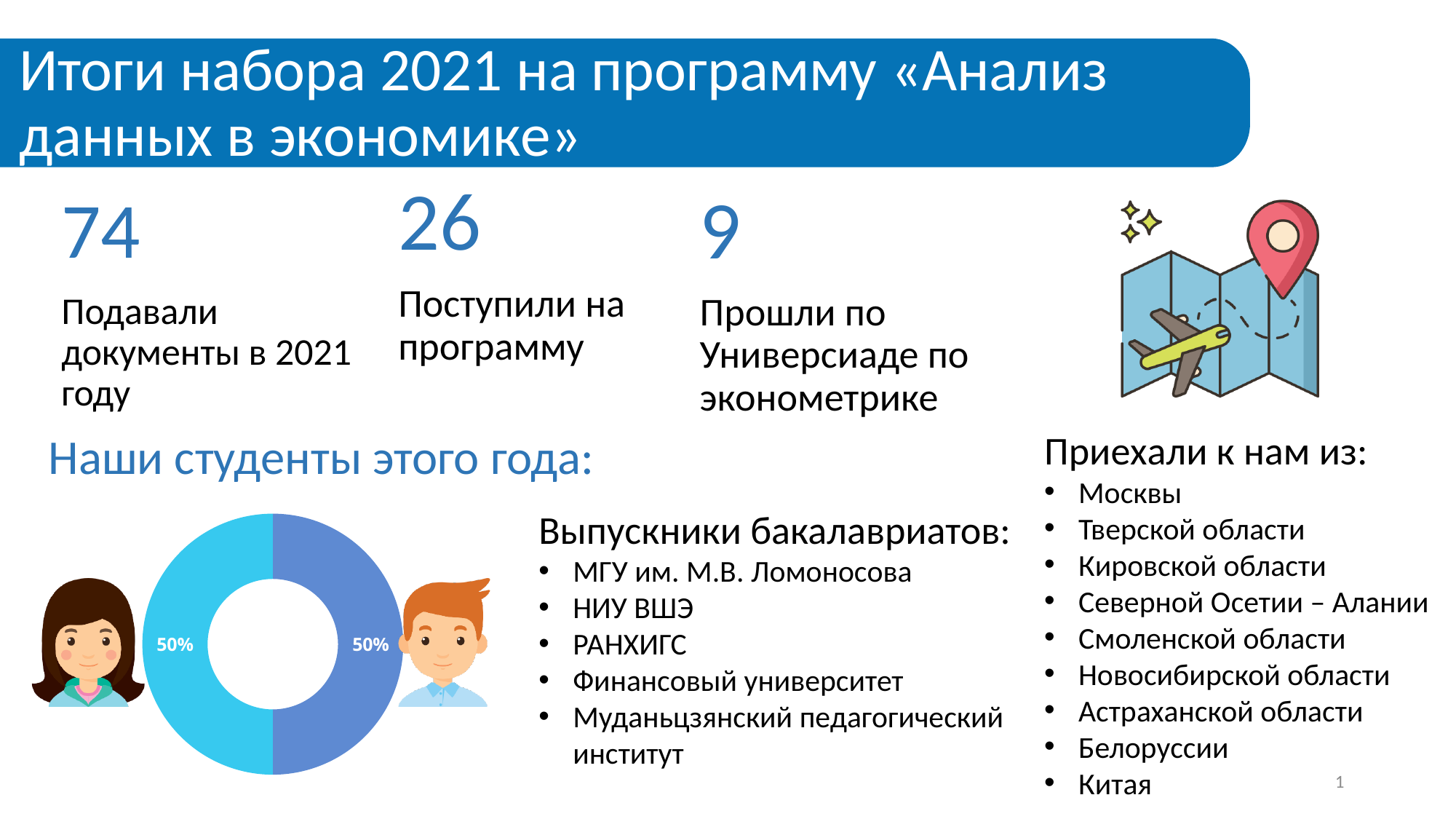
Are the two slices of the donut chart equal in size or is one larger? equal How many slices does the donut chart have? 2 What two colours are used for the slices of the donut chart? light blue and dark blue What share of the donut chart does the slice next to the female figure represent? 50% What percentage is shown on the dark blue (right) slice of the donut chart? 50% What is the difference between the two percentages shown on the donut chart? 0% What kind of chart is shown under the heading «Наши студенты этого года:»? donut (pie) chart What percentage is shown on the light blue (left) slice of the donut chart? 50% What heading appears above the donut chart? Наши студенты этого года: